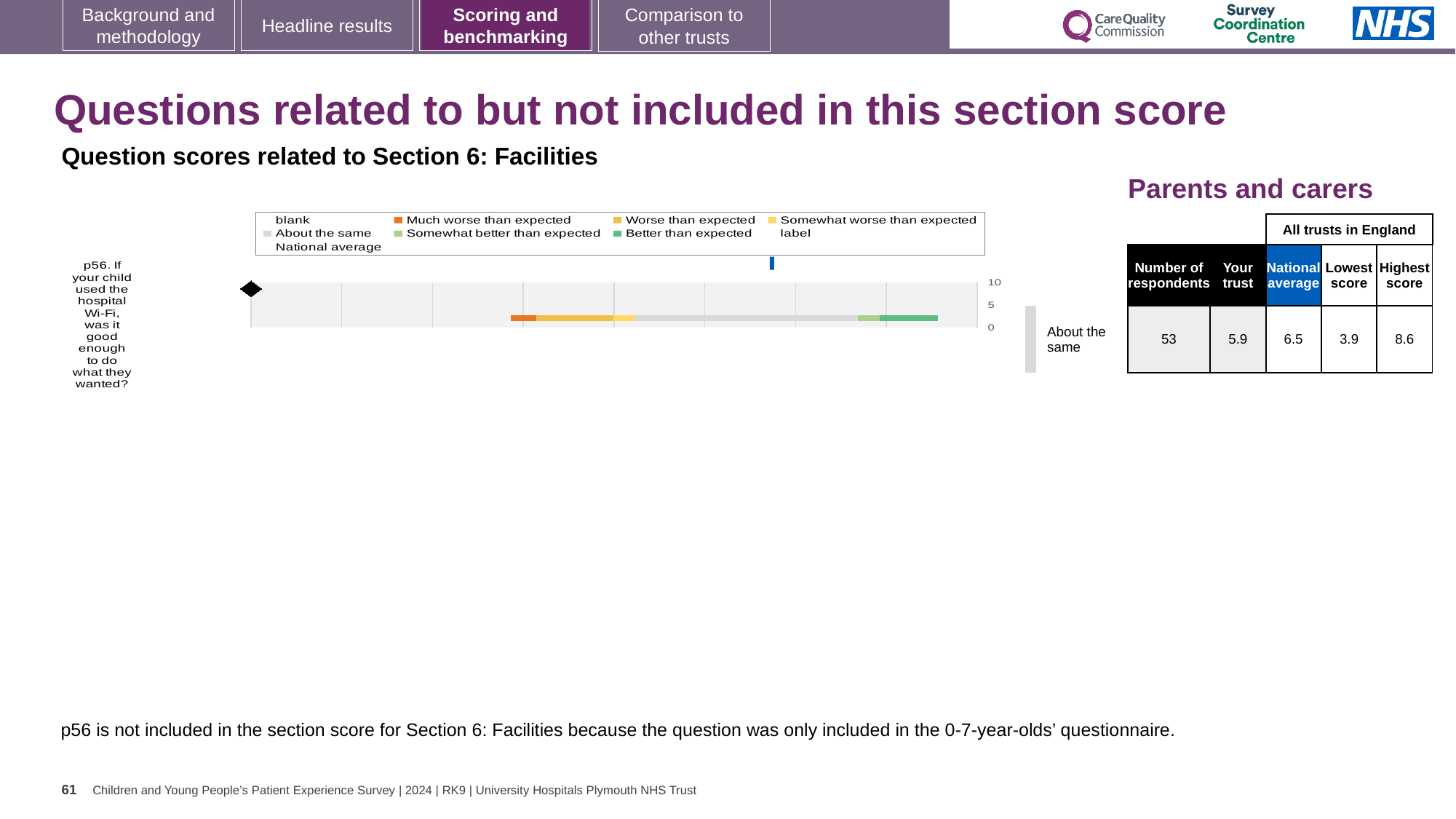
What kind of chart is used to show the p56 benchmarking result? bar chart What is the national average score for p56? 6.5 What is the lowest score among all trusts in England for p56? 3.9 Which survey question is plotted in the chart? p56. If your child used the hospital Wi-Fi, was it good enough to do what they wanted? Which is larger for p56, the 'Your trust' score or the national average? National average What is the highest score among all trusts in England for p56? 8.6 What benchmark category label is shown next to the chart for p56? About the same What is the 'Your trust' score for p56? 5.9 What is the difference between the national average and the 'Your trust' score for p56? 0.6 What is the difference between the highest and lowest scores for p56? 4.7 How many respondents answered p56? 53 How many survey questions are plotted in the chart? 1